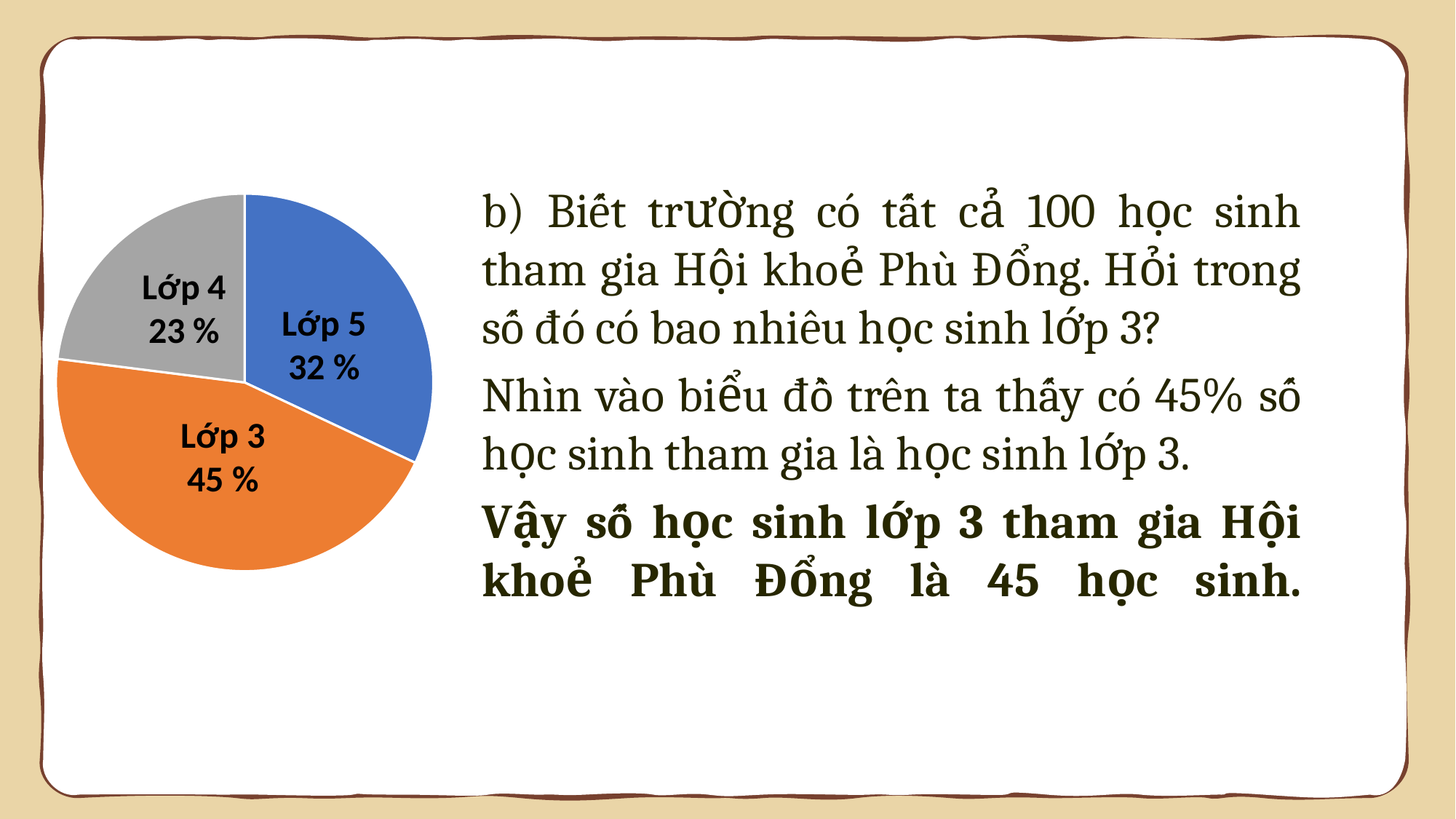
What colour is the slice for Lớp 5? blue Which slice of the pie chart is the largest? Lớp 3 What is the value shown for Lớp 3? 45 % What is the difference between the values for Lớp 5 and Lớp 4? 9 % How many slices does the pie chart have? 3 What is the difference between the values for Lớp 3 and Lớp 5? 13 % Which is larger, the slice for Lớp 4 or the slice for Lớp 5? Lớp 5 What kind of chart is shown on the slide? pie chart What colour is the slice for Lớp 3? orange What is the value shown for Lớp 4? 23 % What is the value shown for Lớp 5? 32 % Which slice of the pie chart is the smallest? Lớp 4